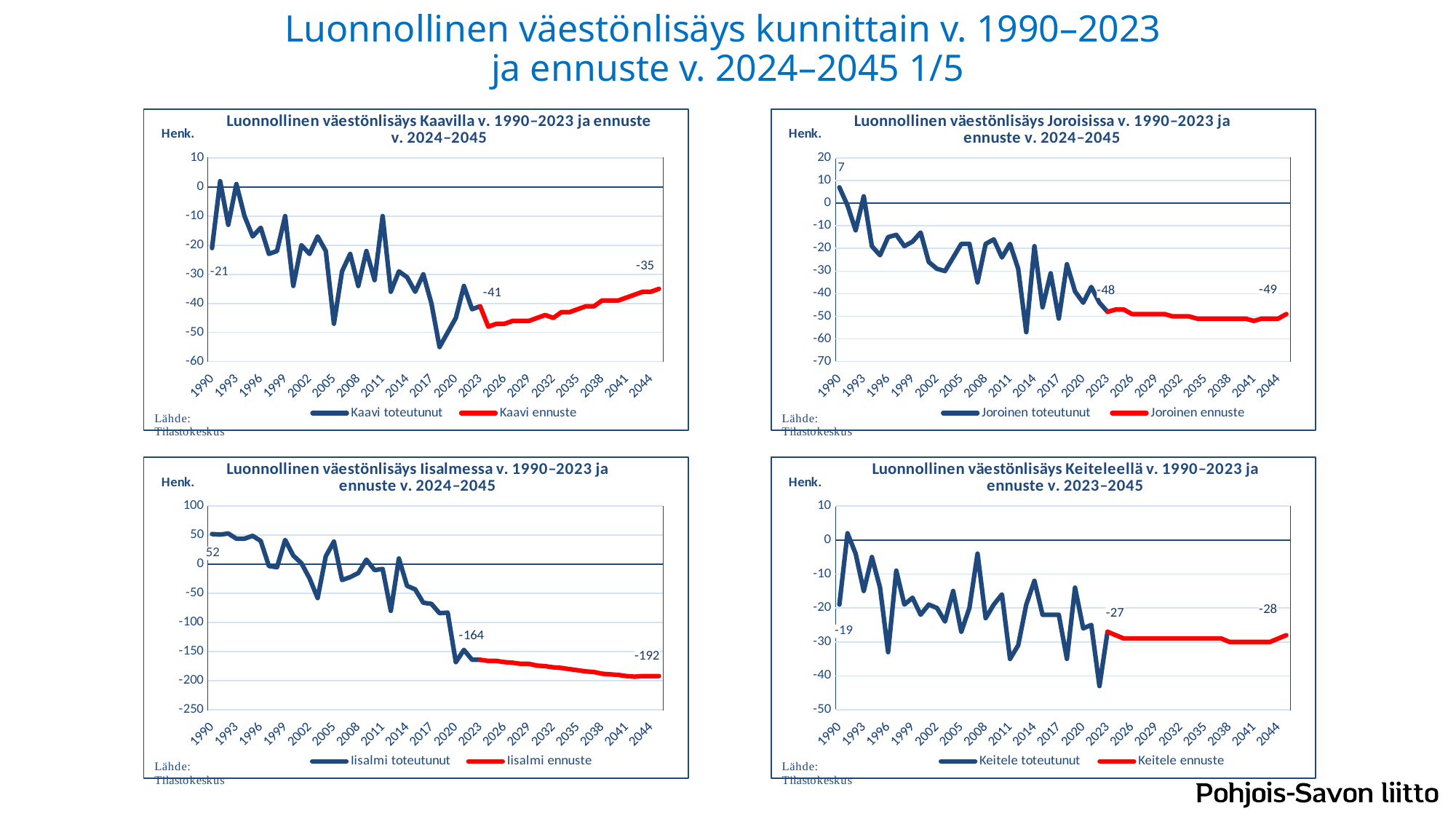
In the Iisalmi chart (bottom left), what is the difference between the labelled 1990 value and the labelled 2023 value? 216 How many series does the legend of the Joroinen chart (top right) list? 2 In the Joroinen chart (top right), what is the labelled value for 1990? 7 In the Joroinen chart (top right), what is the labelled value for 2023? -48 In the Kaavi chart (top left), what is the labelled value at the end of the forecast in 2045? -35 In the Keitele chart (bottom right), what is the labelled value for 2023? -27 In the Iisalmi chart (bottom left), do the values generally rise or fall from 1990 to 2045? Fall In the Iisalmi chart (bottom left), what is the labelled value for 2045? -192 What type of chart is used in each of the four panels on the slide? Line chart In the Kaavi chart (top left), what colour is the forecast (ennuste) line? Red In the Keitele chart (bottom right), which labelled value is larger: 1990 or 2045? 1990 In the Kaavi chart (top left), what is the labelled value for 1990? -21